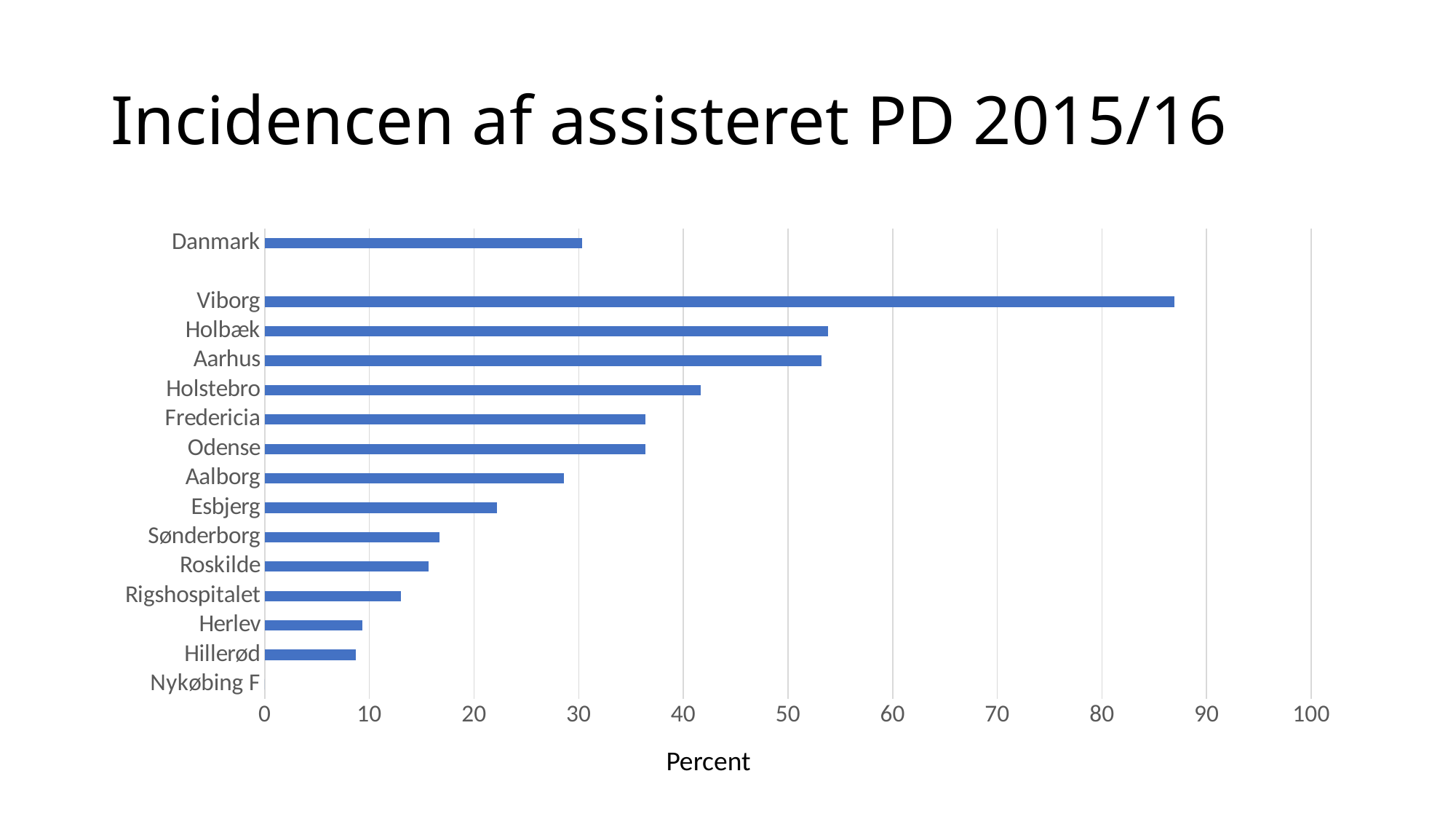
What is the label on the horizontal axis of the chart? Percent Which has a larger value, Holstebro or Aalborg? Holstebro Is the value for Sønderborg greater or less than 20? less Which has a larger value, Esbjerg or Rigshospitalet? Esbjerg Is the value for Holstebro greater or less than 40? greater Which category has the highest value in the chart? Viborg What is the title of the slide? Incidencen af assisteret PD 2015/16 Is the value for Viborg greater or less than 80? greater Which category has the lowest value in the chart? Nykøbing F What kind of chart is shown on the slide? bar chart